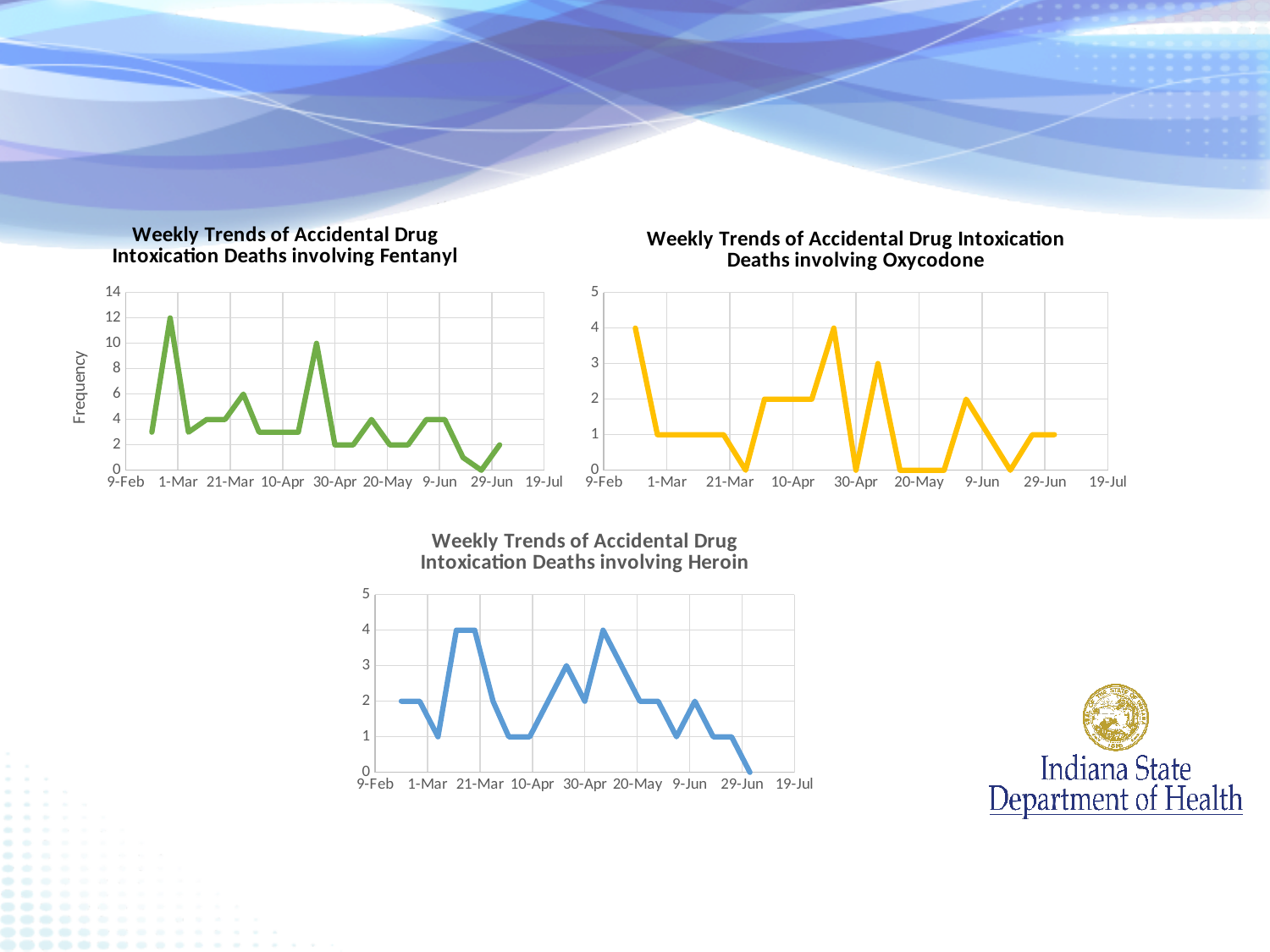
In the Oxycodone chart, what is the highest weekly value reached? 4 In the Fentanyl chart, is the peak value greater or less than 10? greater In the Fentanyl chart, what is the highest weekly frequency reached? 12 How many charts are shown on the slide? 3 Which chart has the higher peak value, the Fentanyl chart or the Oxycodone chart? Fentanyl chart What type of chart is the 'Weekly Trends of Accidental Drug Intoxication Deaths involving Fentanyl' chart? Line chart What is the label on the vertical axis of the Fentanyl chart? Frequency In the Heroin chart, what is the value at the last plotted point (around 29-Jun)? 0 In the Heroin chart, do the values overall rise or fall from the first plotted week to the last? fall In the Heroin chart, what is the highest weekly value reached? 4